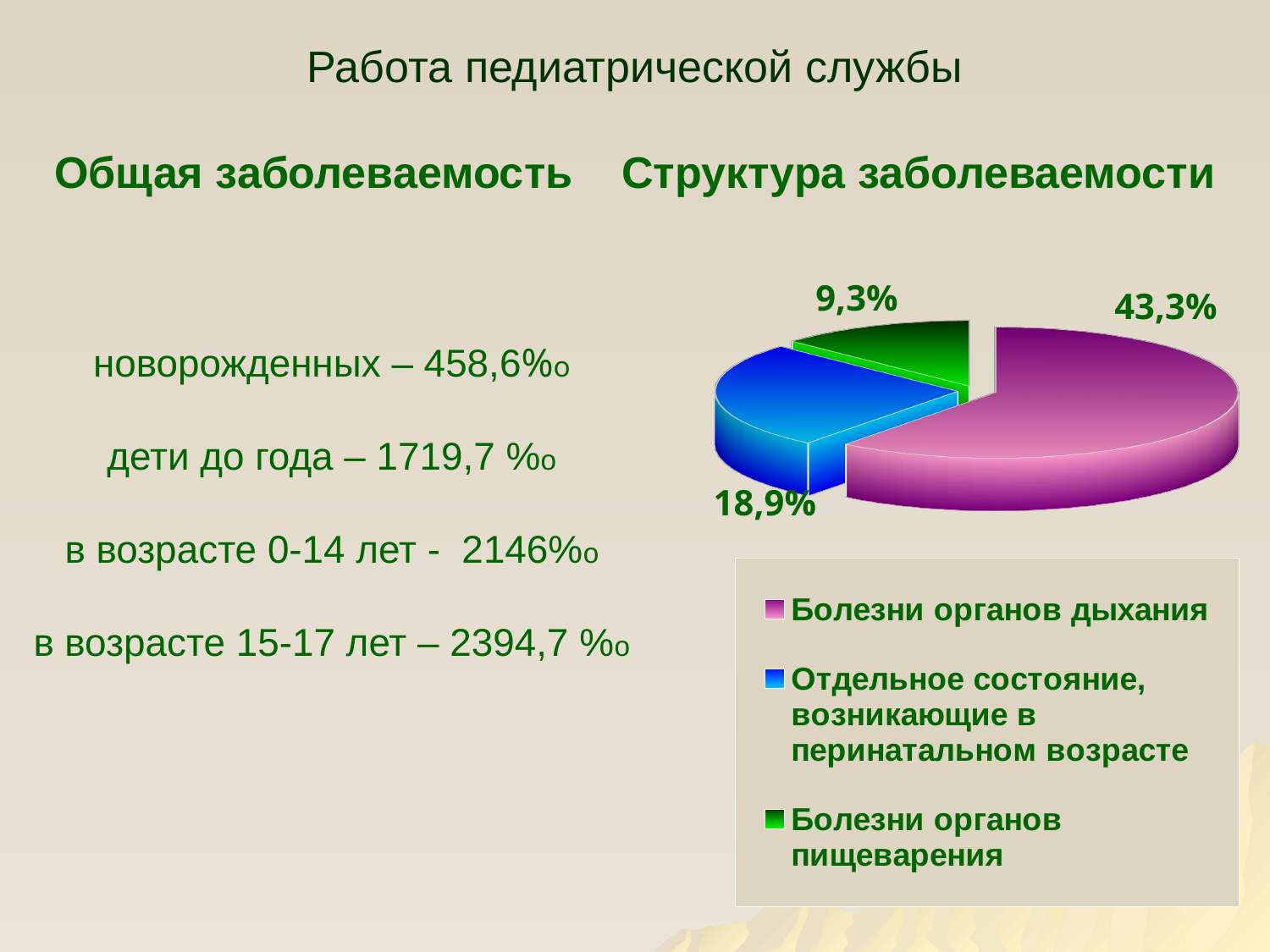
Which category has the largest slice in the pie chart? Болезни органов дыхания How many slices does the pie chart have? 3 What percentage is shown for "Болезни органов пищеварения" in the pie chart? 9,3% Which category has the smallest slice in the pie chart? Болезни органов пищеварения What percentage is shown for "Болезни органов дыхания" in the pie chart? 43,3% What percentage is shown for "Отдельное состояние, возникающие в перинатальном возрасте" in the pie chart? 18,9% Which is larger in the pie chart: "Отдельное состояние, возникающие в перинатальном возрасте" or "Болезни органов пищеварения"? Отдельное состояние, возникающие в перинатальном возрасте How many entries does the legend of the pie chart list? 3 What is the difference in percentage points between "Болезни органов дыхания" and "Болезни органов пищеварения" in the pie chart? 34,0 percentage points What colour is the slice for "Болезни органов пищеварения" in the pie chart? green What kind of chart is shown under "Структура заболеваемости"? pie chart What is the difference in percentage points between "Отдельное состояние, возникающие в перинатальном возрасте" and "Болезни органов пищеварения" in the pie chart? 9,6 percentage points